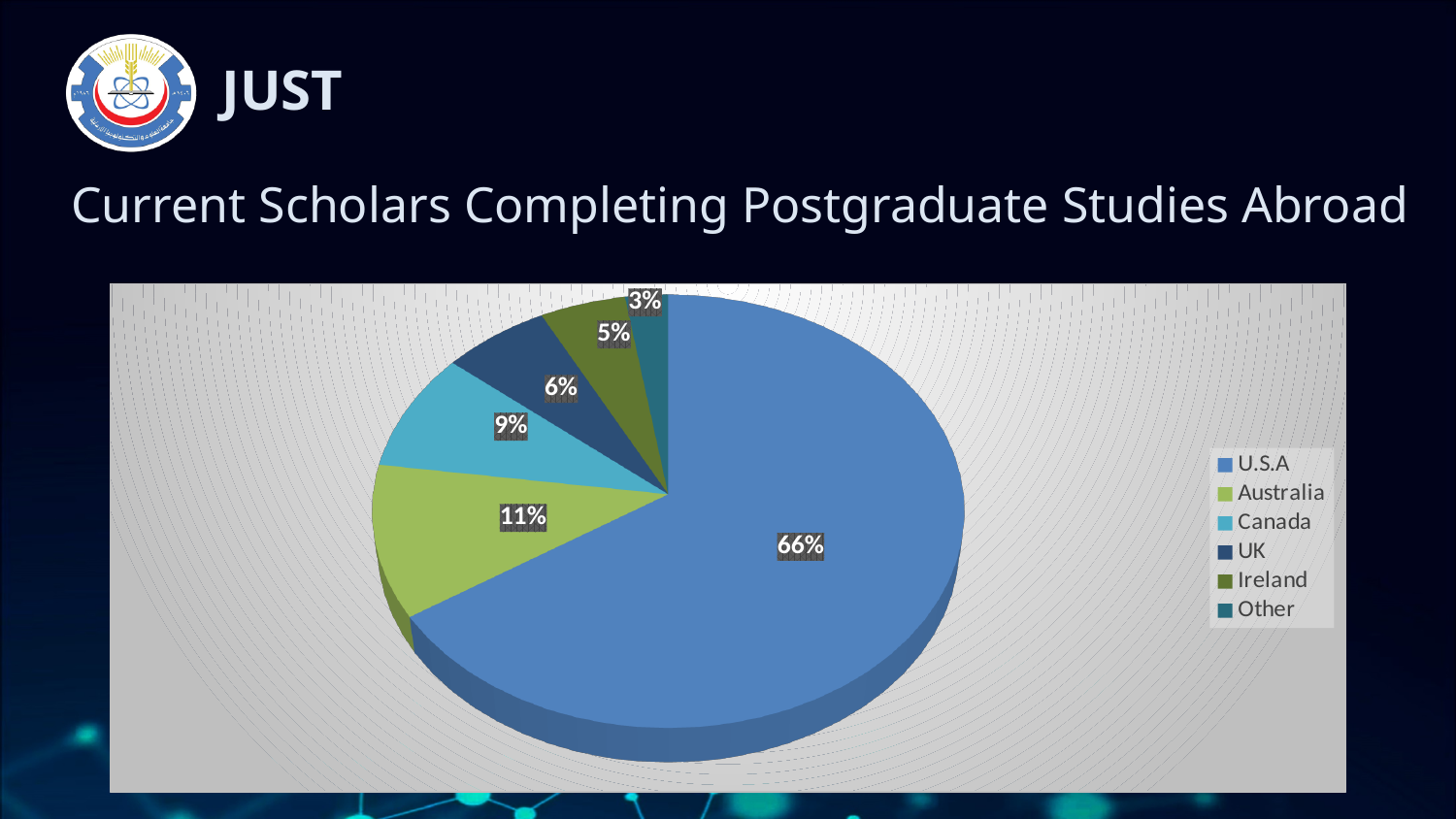
What is the value shown for the UK? 6% What is the value shown for Australia? 11% What is the value shown for Canada? 9% What is the value shown for Ireland? 5% Which category has the largest share of the pie? U.S.A How many categories does the legend list? 6 Which has a larger share, Canada or Ireland? Canada What is the title of the slide containing the chart? Current Scholars Completing Postgraduate Studies Abroad What is the difference between the shares for U.S.A and Australia? 55% What share of the pie does U.S.A account for? 66% Which category has the smallest share of the pie? Other What kind of chart is shown on the slide? Pie chart